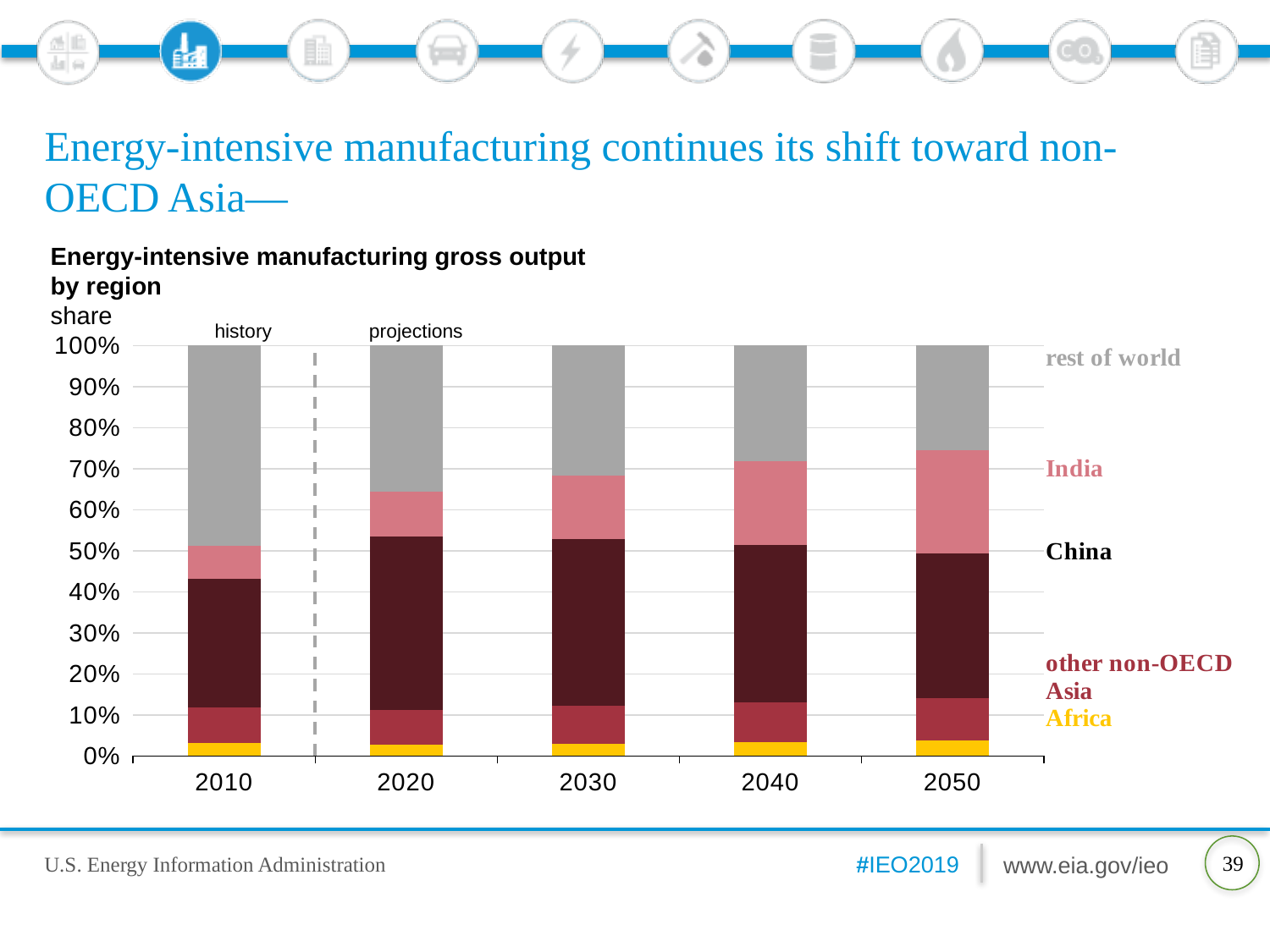
Is India's share larger in 2010 or in 2050? 2050 Is the combined share of Africa, other non-OECD Asia and China in 2010 greater or less than 50%? less What is the title of the chart? Energy-intensive manufacturing gross output by region How many regions (series) does the chart's legend list? 5 In which year is the rest of world share the largest? 2010 Is the combined share of Africa, other non-OECD Asia and China in 2020 greater or less than 50%? greater What does each stacked bar in the chart total? 100% Does the rest of world share rise or fall from 2010 to 2050? fall Does India's share rise or fall from 2010 to 2050? rise How many years are shown along the x axis of the chart? 5 Which region has the smallest share in every year shown? Africa What kind of chart is shown on the slide? stacked bar chart